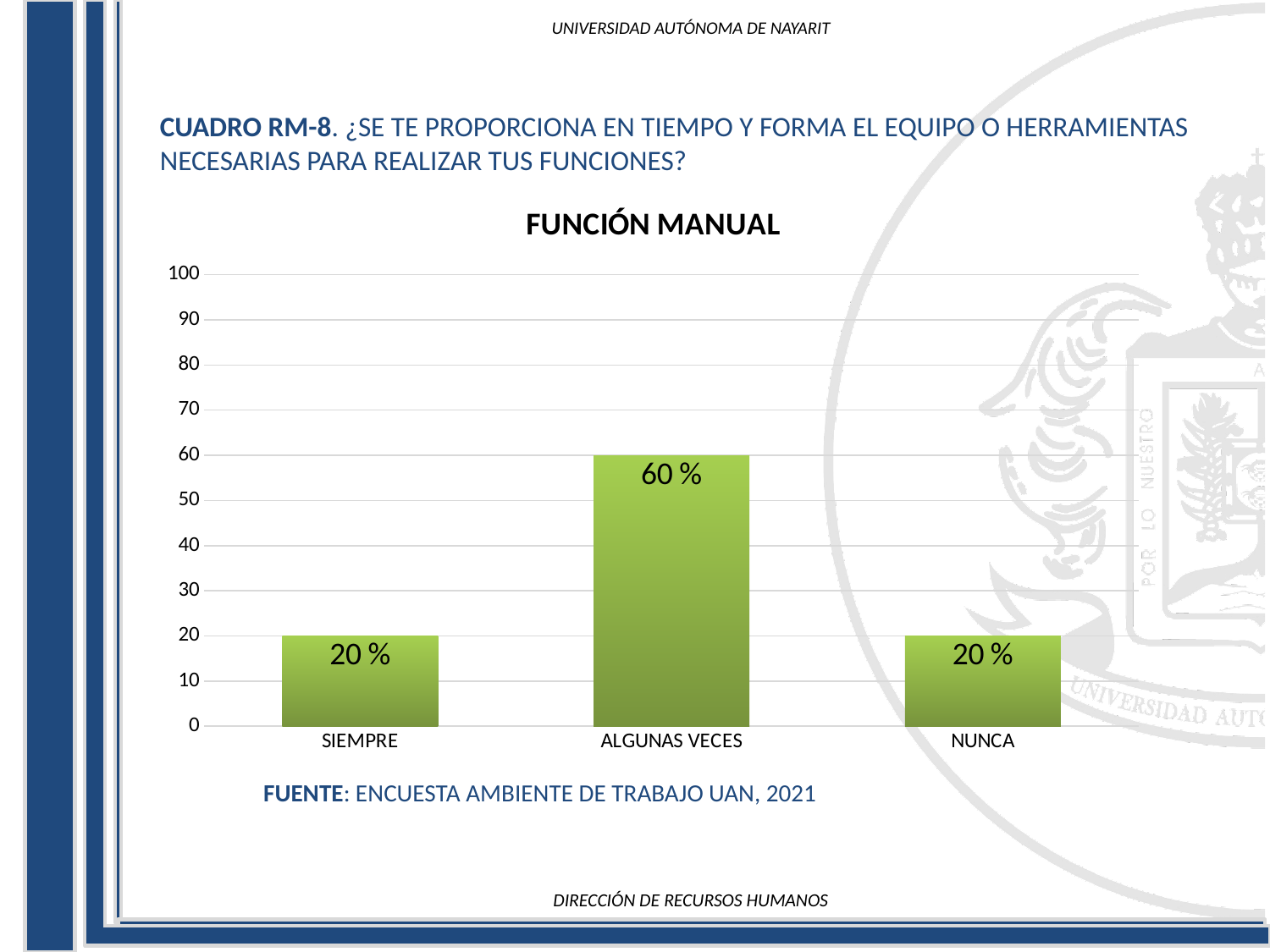
What is the value for ALGUNAS VECES? 60 % What is the value for SIEMPRE? 20 % Is the value for SIEMPRE greater or less than 30? less What is the title of the chart? FUNCIÓN MANUAL Which category has the highest value? ALGUNAS VECES What is the value for NUNCA? 20 % Is the value for ALGUNAS VECES greater or less than 50? greater What is the difference between the values for ALGUNAS VECES and SIEMPRE? 40 % How many categories are shown on the x axis? 3 What is the maximum value shown on the y axis? 100 Which is larger, the value for ALGUNAS VECES or the value for NUNCA? ALGUNAS VECES What kind of chart is shown on the slide? bar chart